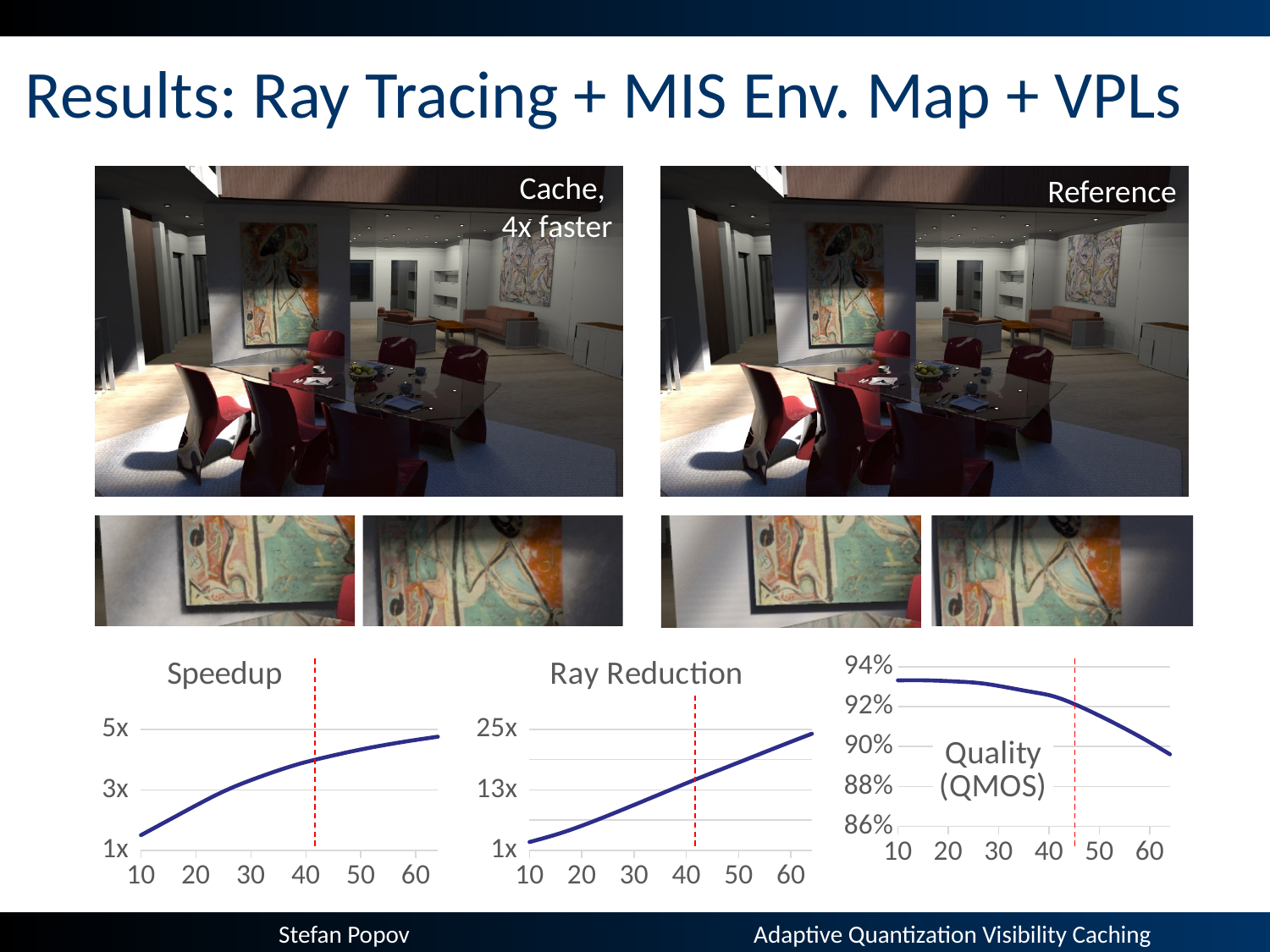
In the Ray Reduction chart, do the values rise or fall along the x axis? rise How many charts are shown at the bottom of the slide? 3 In the Quality (QMOS) chart, is the value at x = 40 greater or less than 90%? greater In the Speedup chart, do the values rise or fall as the x axis increases from 10 to 60? rise In the Quality (QMOS) chart, is the value at x = 10 greater or less than 92%? greater In the Speedup chart, is the value at x = 40 greater or less than 3x? greater In the Quality (QMOS) chart, do the values rise or fall as the x axis increases? fall What kind of chart is the Speedup chart? line chart What is the highest y-axis tick label shown on the Ray Reduction chart? 25x